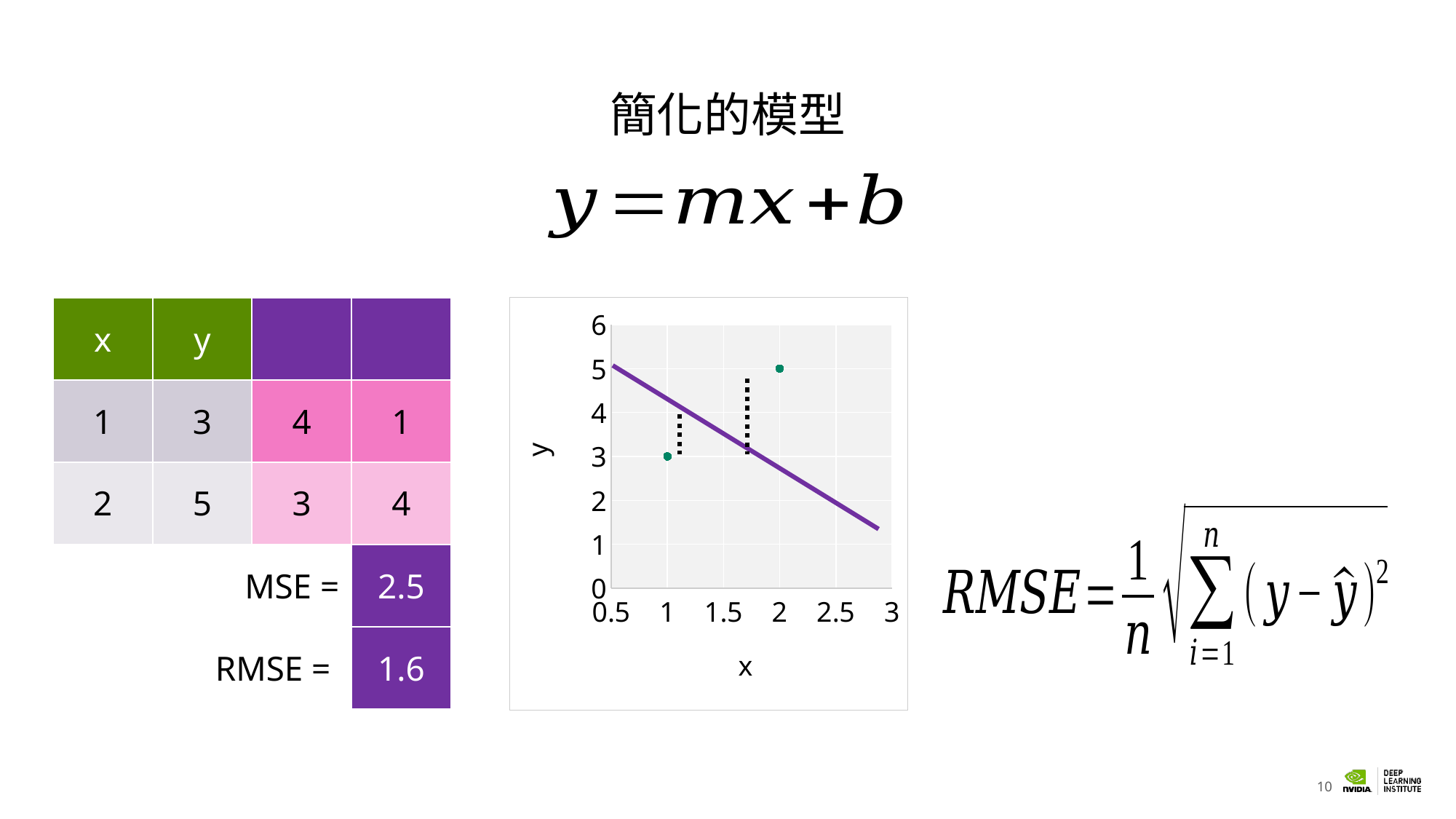
What is the y value of the data point at x = 2? 5 What is the difference between the y values of the two plotted points? 2 Does the purple line rise or fall as x increases? fall Is the value of the purple line at x = 0.5 greater or less than 4? greater How many data points are plotted on the chart? 2 Is the value of the purple line at x = 3 greater or less than 2? less What kind of chart is shown on the slide? scatter chart What is the y value of the data point at x = 1? 3 Which data point has the higher y value, the one at x = 1 or the one at x = 2? x = 2 What is the label on the horizontal axis of the chart? x What is the highest tick value shown on the vertical axis? 6 What is the label on the vertical axis of the chart? y